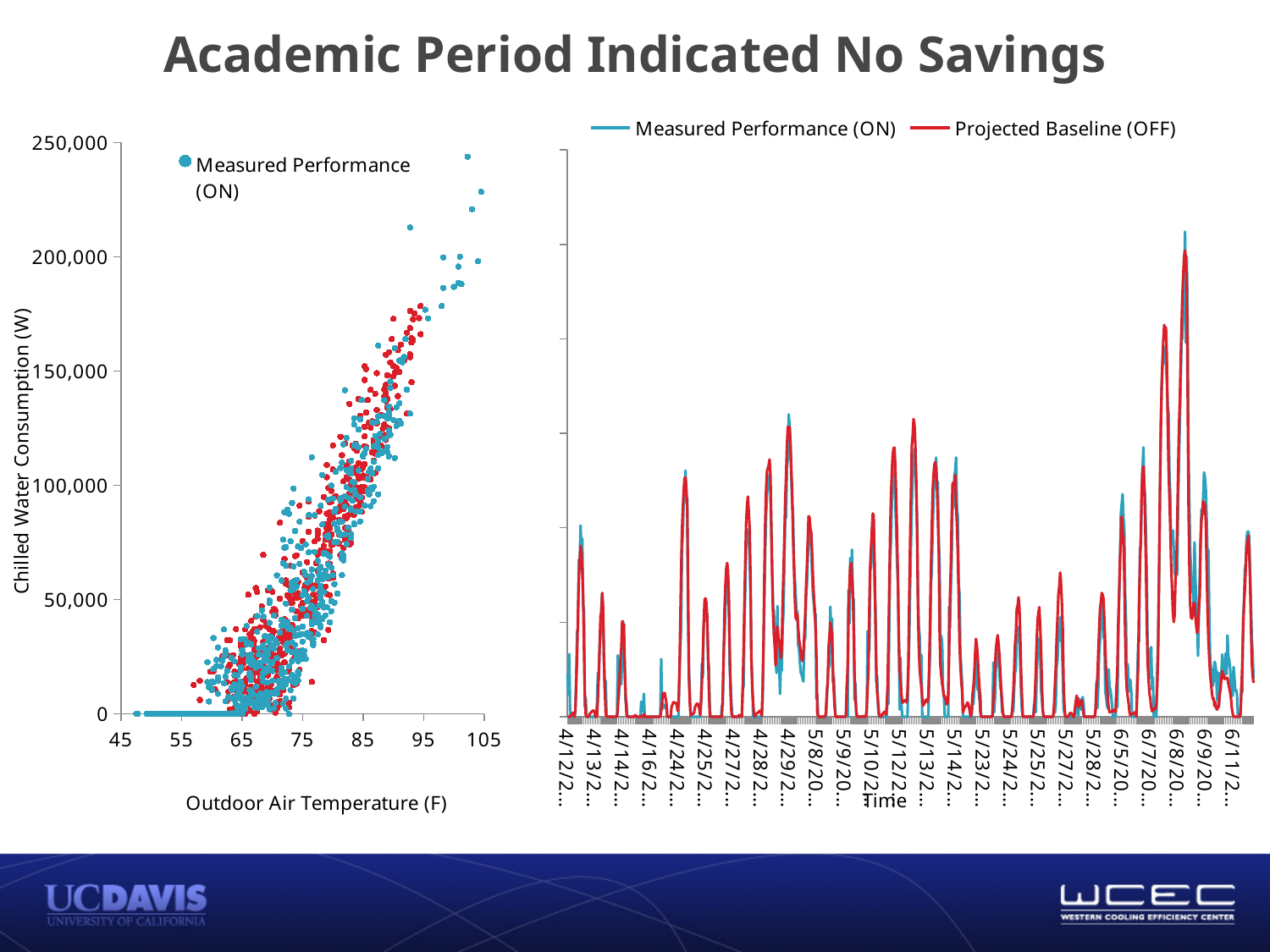
In the left chart, does chilled water consumption generally rise or fall as outdoor air temperature increases? rise What is the x-axis label of the left chart? Outdoor Air Temperature (F) What are the two series named in the legend of the right chart? Measured Performance (ON) and Projected Baseline (OFF) How many tick labels are shown on the x-axis of the left chart? 7 What is the y-axis label of the left chart? Chilled Water Consumption (W) What kind of chart is the right chart on the slide? line chart How many series does the legend of the right chart list? 2 What kind of chart is the left chart on the slide? scatter plot In the left chart, do the points at 95 F lie above or below 150,000 W? above In the left chart, do the points at 55 F lie above or below 50,000 W? below